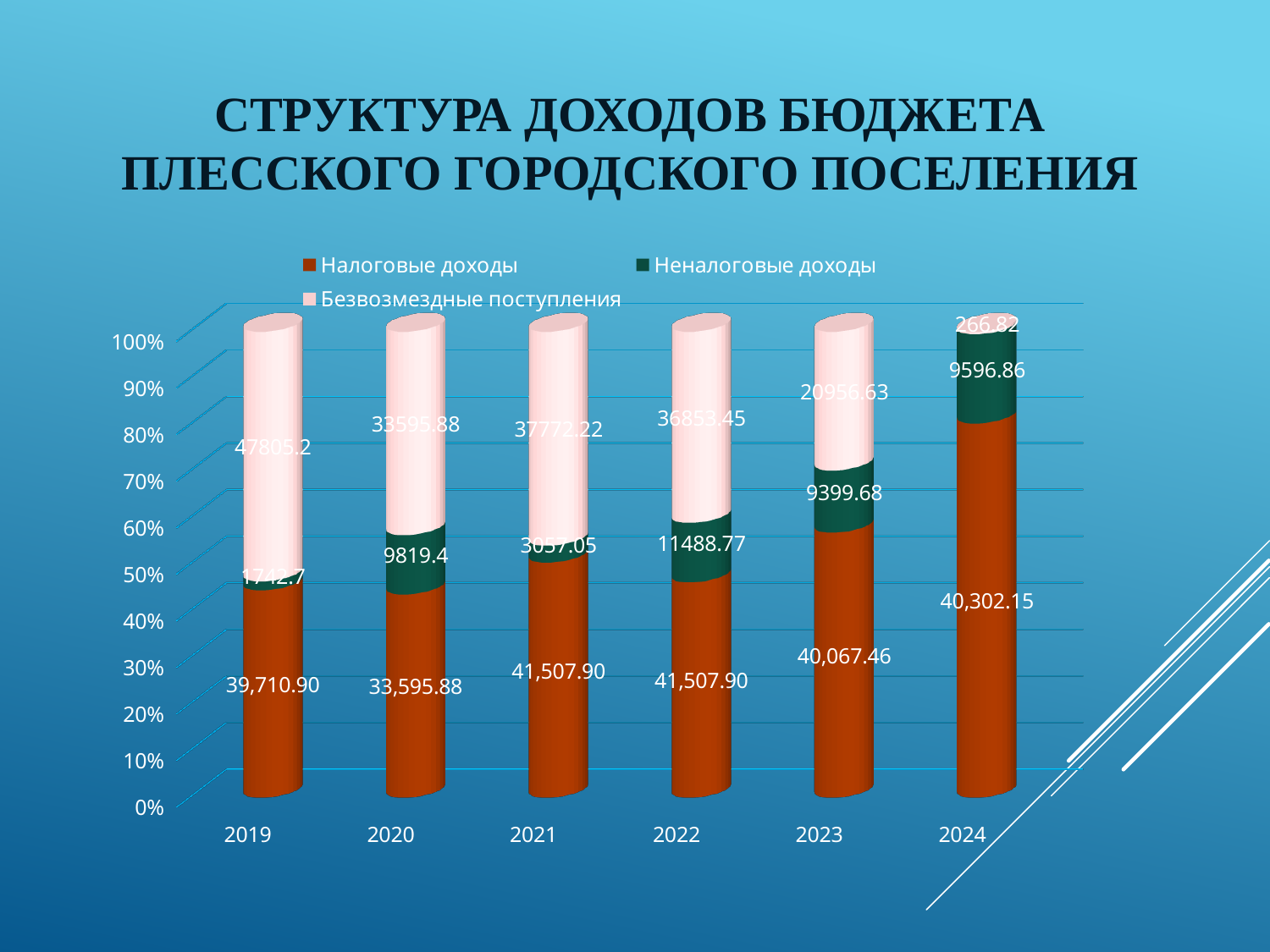
What is the value of Налоговые доходы for 2019? 39,710.90 In which year is Безвозмездные поступления lowest? 2024 What is the value of Неналоговые доходы for 2024? 9596.86 What is the value of Безвозмездные поступления for 2023? 20956.63 What kind of chart is shown on the slide? Stacked bar chart How many years are shown on the x axis? 6 What is the difference between Налоговые доходы in 2021 and in 2020? 7,912.02 Which is larger: Неналоговые доходы in 2022 or in 2021? 2022 In which year is Безвозмездные поступления highest? 2019 How many series does the legend list? 3 In which year is Неналоговые доходы highest? 2022 Is the share of Налоговые доходы in 2023 greater or less than 50%? greater